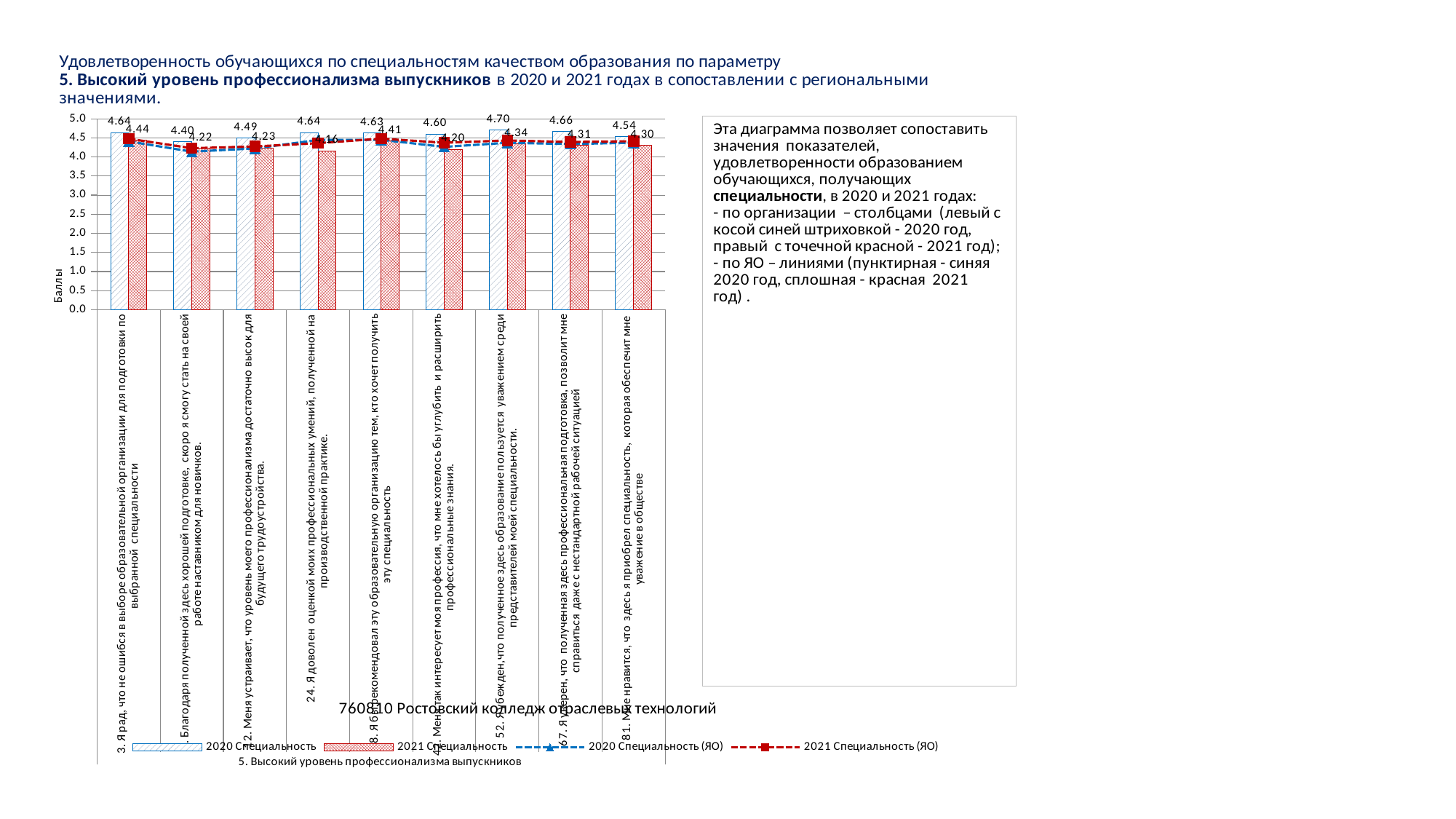
Which category has the highest 2020 Специальность value? 52. Я убежден, что полученное здесь образование пользуется уважением среди представителей моей специальности What is the 2020 Специальность value for the category "24. Я доволен оценкой моих профессиональных умений, полученной на производственной практике"? 4.64 How many series does the chart legend list? 4 What is the 2021 Специальность value for the category "81. Мне нравится, что здесь я приобрел специальность, которая обеспечит мне уважение в обществе"? 4.30 What is the 2021 Специальность value for the category "24. Я доволен оценкой моих профессиональных умений, полученной на производственной практике"? 4.16 For the category "3. Я рад, что не ошибся в выборе образовательной организации для подготовки по выбранной специальности", which is larger: the 2020 Специальность value or the 2021 Специальность value? 2020 Специальность Is the 2021 Специальность value for the category "52. Я убежден, что полученное здесь образование пользуется уважением среди представителей моей специальности" greater or less than 4.0? greater What is the difference between the 2020 and 2021 Специальность values for the category "24. Я доволен оценкой моих профессиональных умений, полученной на производственной практике"? 0.48 Which category has the lowest 2021 Специальность value? 24. Я доволен оценкой моих профессиональных умений, полученной на производственной практике What kind of chart is shown on the slide? Combined bar and line chart How many categories are shown on the x axis of the chart? 9 What is the label of the vertical axis of the chart? Баллы